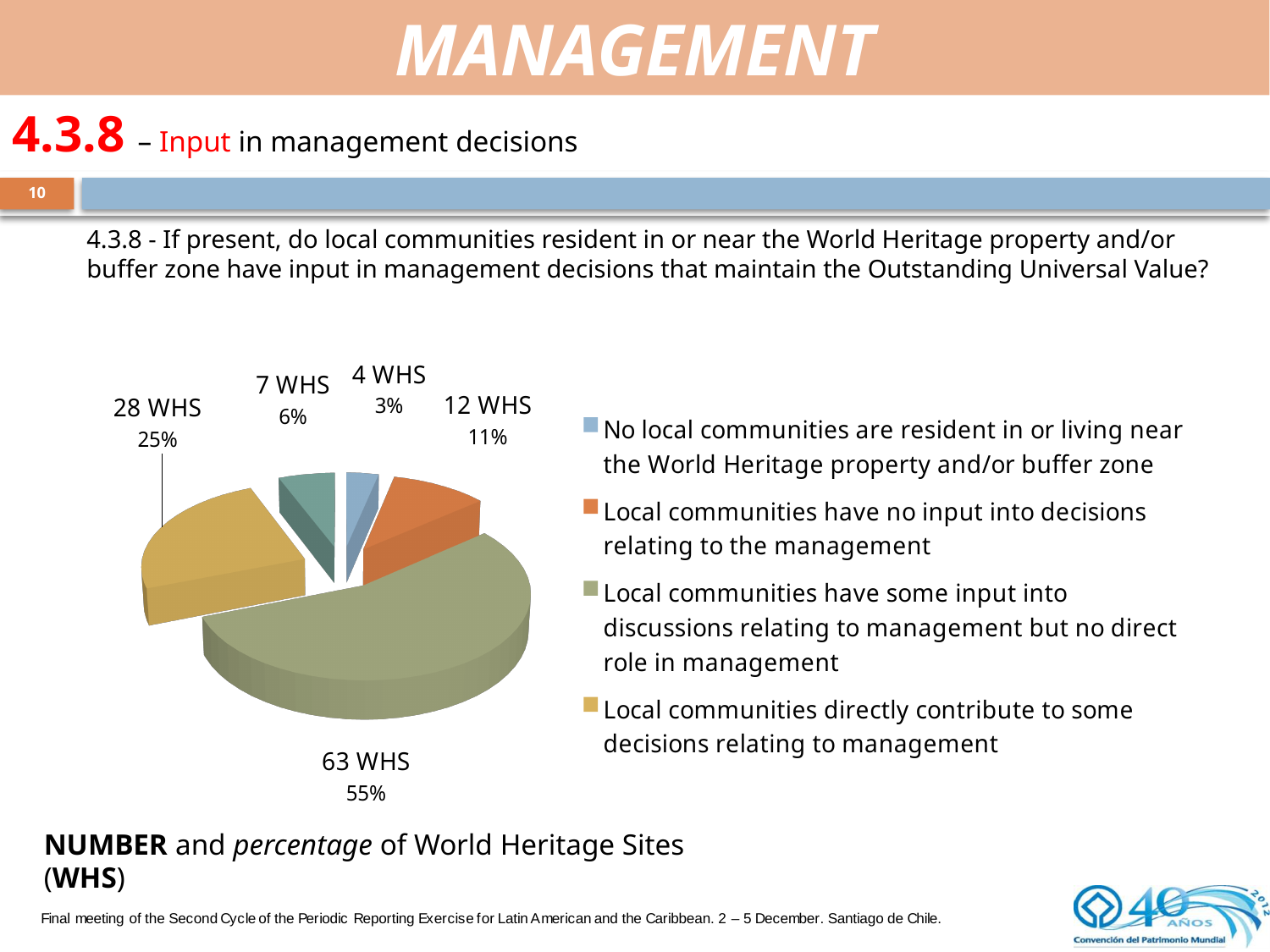
How many slices does the pie chart have? 5 What share of the pie is the category 'Local communities have no input into decisions relating to the management'? 11% How many World Heritage Sites are in the category 'Local communities have some input into discussions relating to management but no direct role in management'? 63 WHS Which legend category has the smallest slice of the pie? No local communities are resident in or living near the World Heritage property and/or buffer zone What is the difference in number of WHS between the 63 WHS slice and the 28 WHS slice? 35 WHS What kind of chart is shown on the slide? Pie chart Which is larger: the slice for 'Local communities have no input into decisions relating to the management' or the slice for 'Local communities directly contribute to some decisions relating to management'? Local communities directly contribute to some decisions relating to management Which category has the largest slice of the pie? Local communities have some input into discussions relating to management but no direct role in management How many entries does the legend list? 4 What colour is the slice representing 'Local communities have some input into discussions relating to management but no direct role in management'? Green How many World Heritage Sites are in the category 'No local communities are resident in or living near the World Heritage property and/or buffer zone'? 4 WHS What percentage of World Heritage Sites fall in the category 'Local communities directly contribute to some decisions relating to management'? 25%